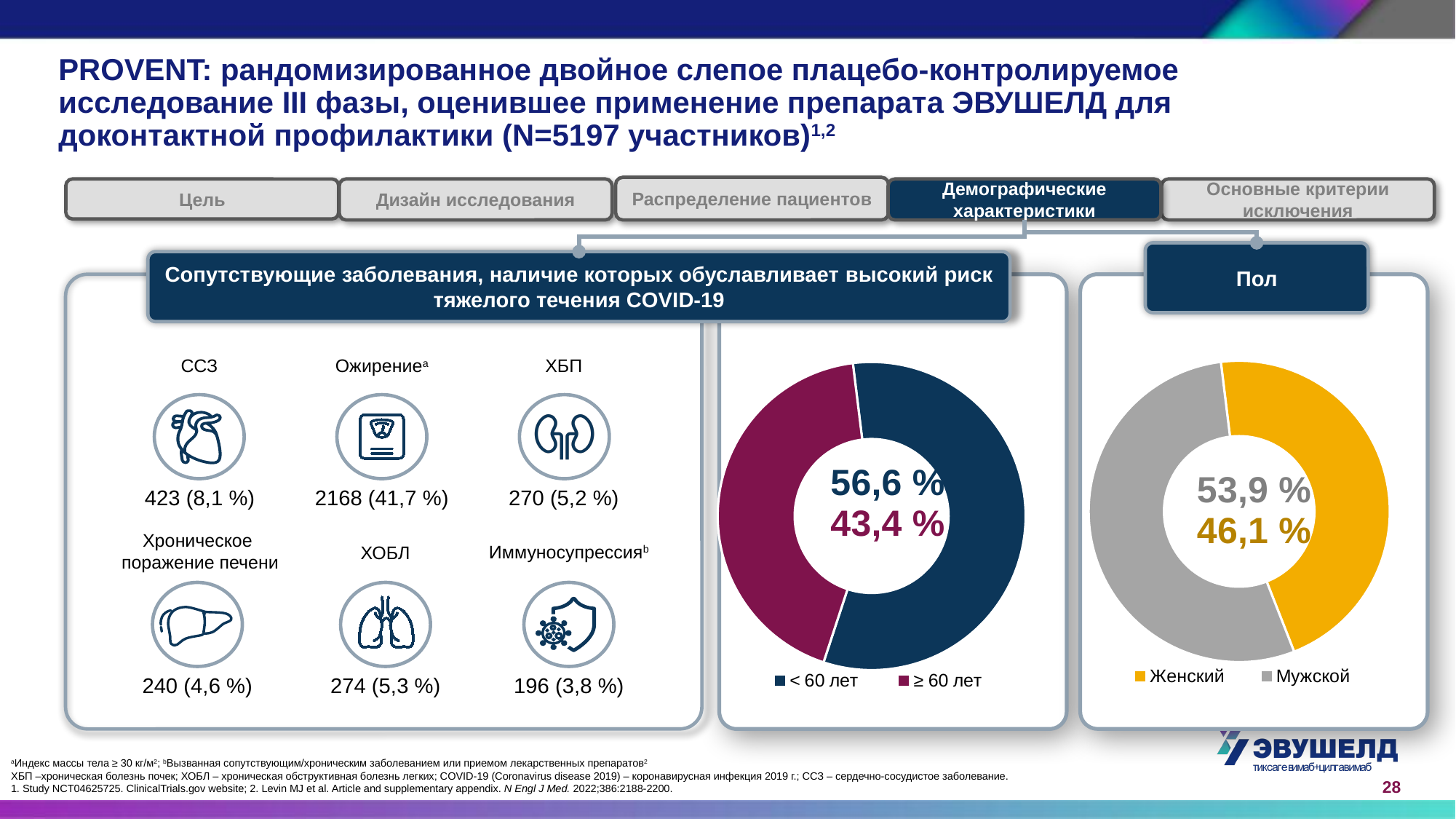
In the middle donut chart (age groups), which colour represents ≥ 60 лет? Maroon (dark red) In the middle donut chart (age groups), what is the difference in percentage points between the < 60 лет and ≥ 60 лет shares? 13,2 In the middle donut chart (age groups), how many series does the legend list? 2 In the 'Пол' donut chart on the right, which colour represents Женский? Yellow What type of chart is used in the 'Пол' panel on the right? Pie (donut) chart In the middle donut chart (age groups), which age group has the larger share? < 60 лет In the middle donut chart (age groups), what share of participants is shown for < 60 лет? 56,6 % In the 'Пол' donut chart on the right, what share is shown for Мужской? 53,9 % In the 'Пол' donut chart on the right, which sex has the smaller share? Женский In the 'Пол' donut chart on the right, what share is shown for Женский? 46,1 % In the middle donut chart (age groups), what share of participants is shown for ≥ 60 лет? 43,4 % In the 'Пол' donut chart on the right, is the share for Мужской larger or smaller than the share for Женский? Larger